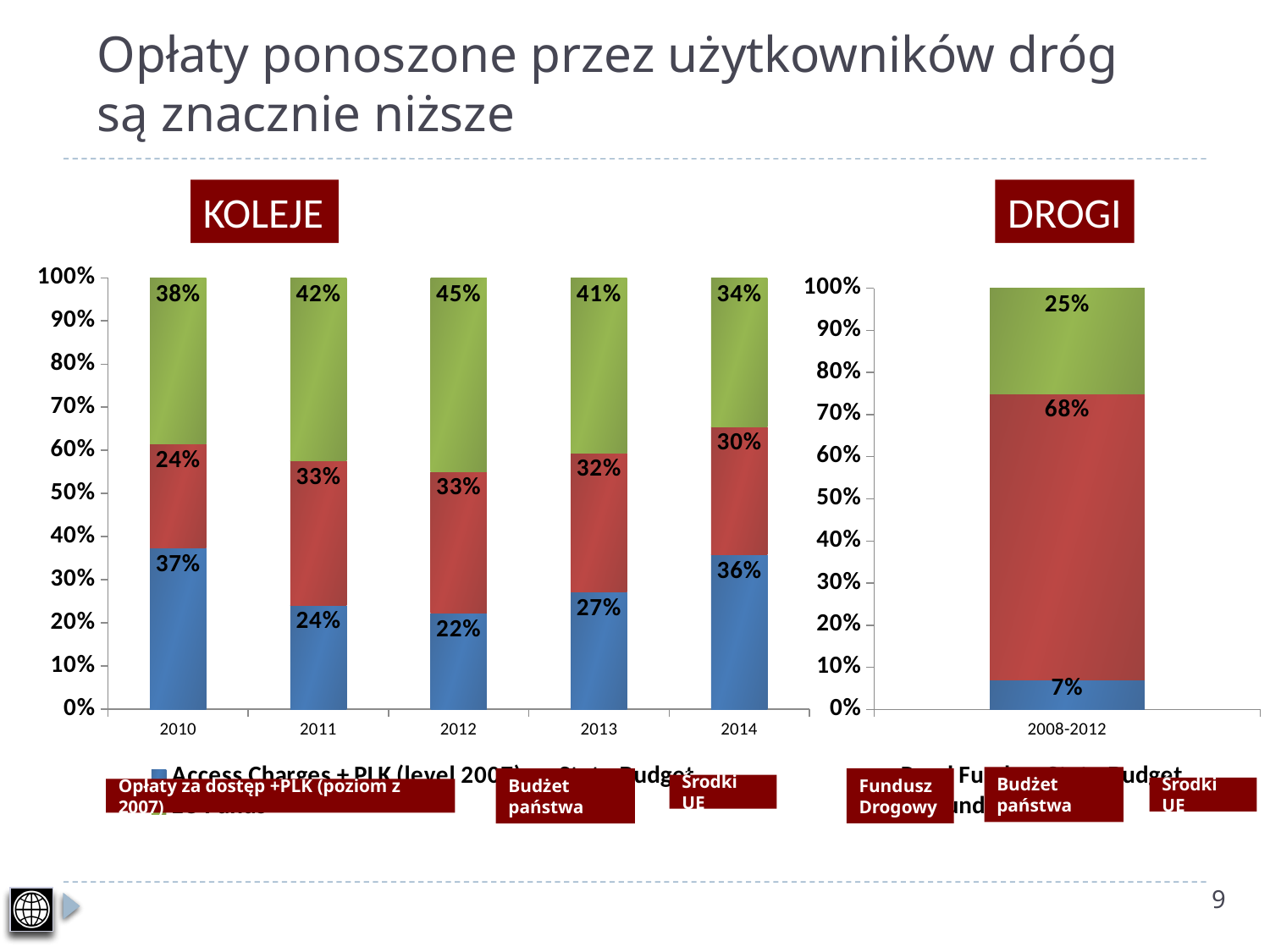
What type of chart is the DROGI chart? Stacked bar chart How many years are shown on the x axis of the KOLEJE chart? 5 In the KOLEJE chart, what is the value of the blue (Opłaty za dostęp +PLK) segment for 2010? 37% In the KOLEJE chart, does the blue (Opłaty za dostęp +PLK) segment rise or fall from 2010 to 2012? Fall In the KOLEJE chart, is the blue segment larger in 2010 or in 2011? 2010 In the KOLEJE chart, what is the value of the green (Środki UE) segment for 2012? 45% In the KOLEJE chart, what is the value of the red (Budżet państwa) segment for 2013? 32% In the KOLEJE chart, what is the difference between the green segment values for 2012 and 2014? 11% In the KOLEJE chart, which year has the lowest blue (Opłaty za dostęp +PLK) share? 2012 In the DROGI chart, what is the value of the red (Budżet państwa) segment for 2008-2012? 68% In the KOLEJE chart, which year has the highest green (Środki UE) share? 2012 In the DROGI chart, what is the value of the blue (Fundusz Drogowy) segment? 7%